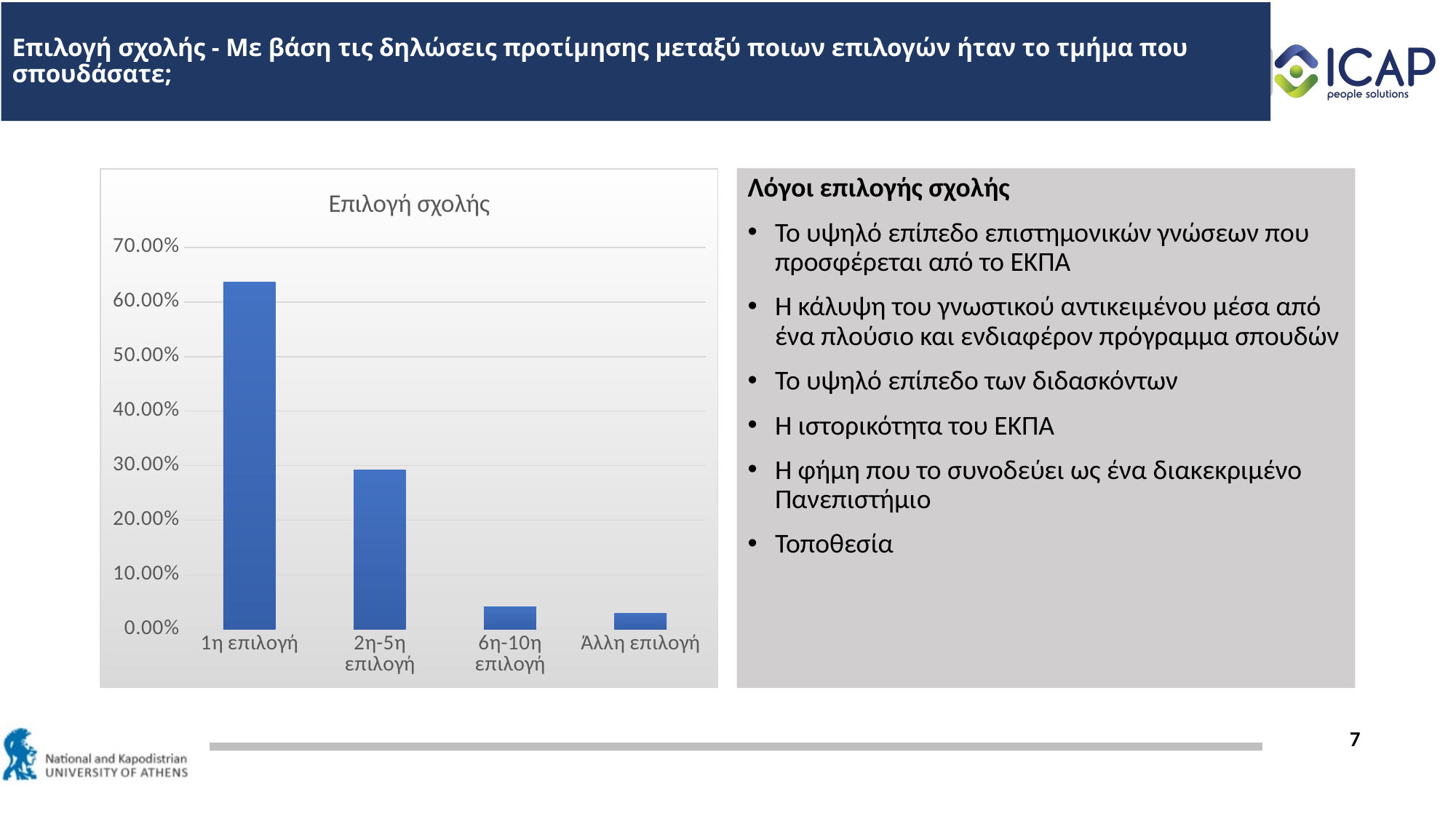
Which category has the highest value in the chart? 1η επιλογή What is the title of the chart? Επιλογή σχολής What is the highest value shown on the y axis of the chart? 70.00% Is the value for 6η-10η επιλογή greater or less than 10.00%? less Which is larger, the value for 1η επιλογή or the value for 2η-5η επιλογή? 1η επιλογή How many categories are shown on the x axis of the chart? 4 Is the value for 1η επιλογή greater or less than 60.00%? greater Do the values rise or fall moving from left to right along the x axis? fall What kind of chart is shown on the slide? bar chart Which category has the lowest value in the chart? Άλλη επιλογή Is the value for 2η-5η επιλογή greater or less than 20.00%? greater